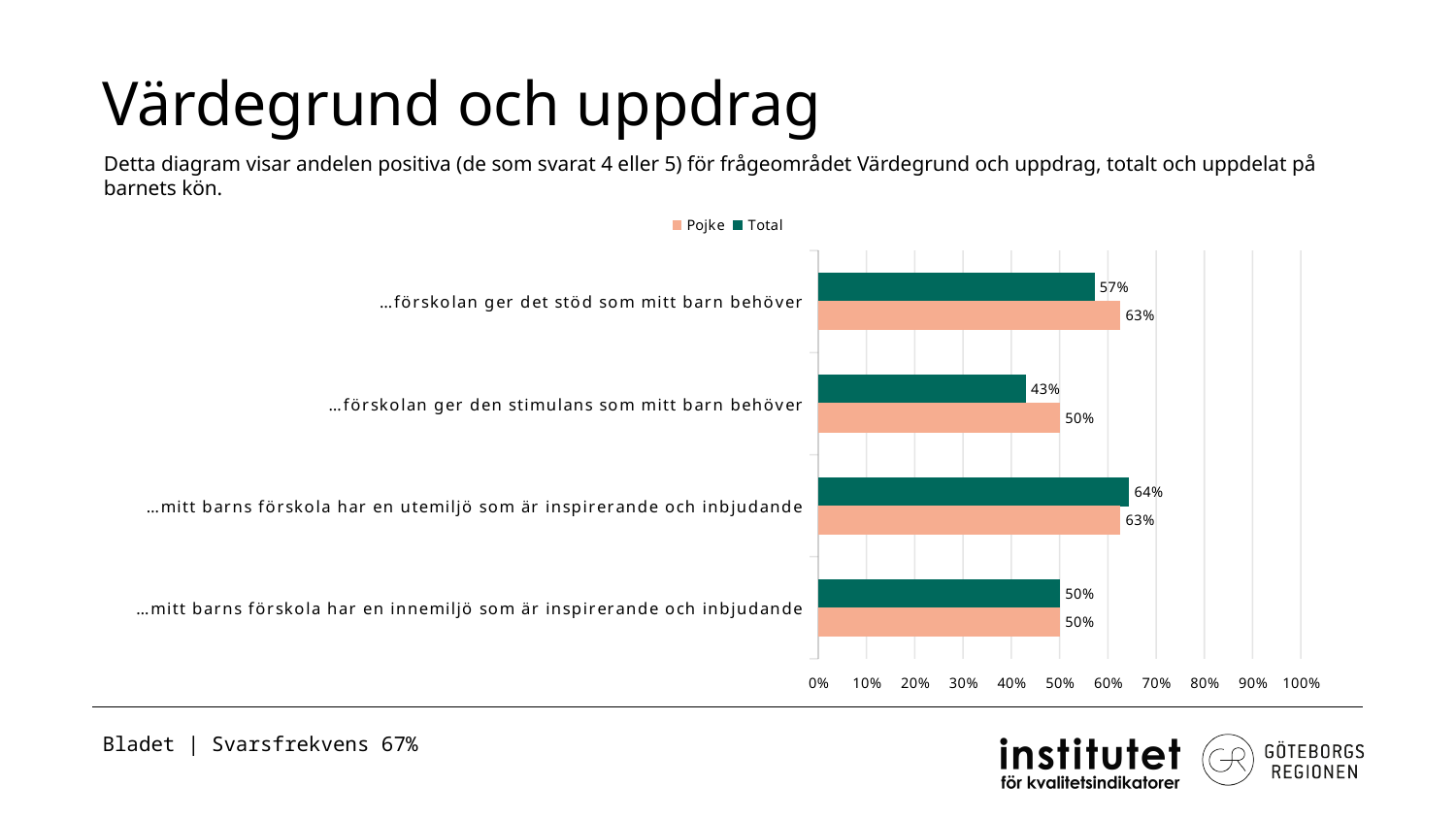
What is the difference between the Pojke and Total values for "…förskolan ger den stimulans som mitt barn behöver"? 7% For "…förskolan ger det stöd som mitt barn behöver", which is larger, the Pojke value or the Total value? Pojke What is the Total value for "…mitt barns förskola har en utemiljö som är inspirerande och inbjudande"? 64% How many series does the legend list? 2 How many categories are shown on the chart? 4 Which category has the lowest Total value? …förskolan ger den stimulans som mitt barn behöver Which series is shown in green? Total What type of chart is shown on the slide? bar chart What is the Pojke value for "…förskolan ger den stimulans som mitt barn behöver"? 50% What is the Total value for "…förskolan ger det stöd som mitt barn behöver"? 57% Which category has the highest Total value? …mitt barns förskola har en utemiljö som är inspirerande och inbjudande What is the Pojke value for "…mitt barns förskola har en innemiljö som är inspirerande och inbjudande"? 50%